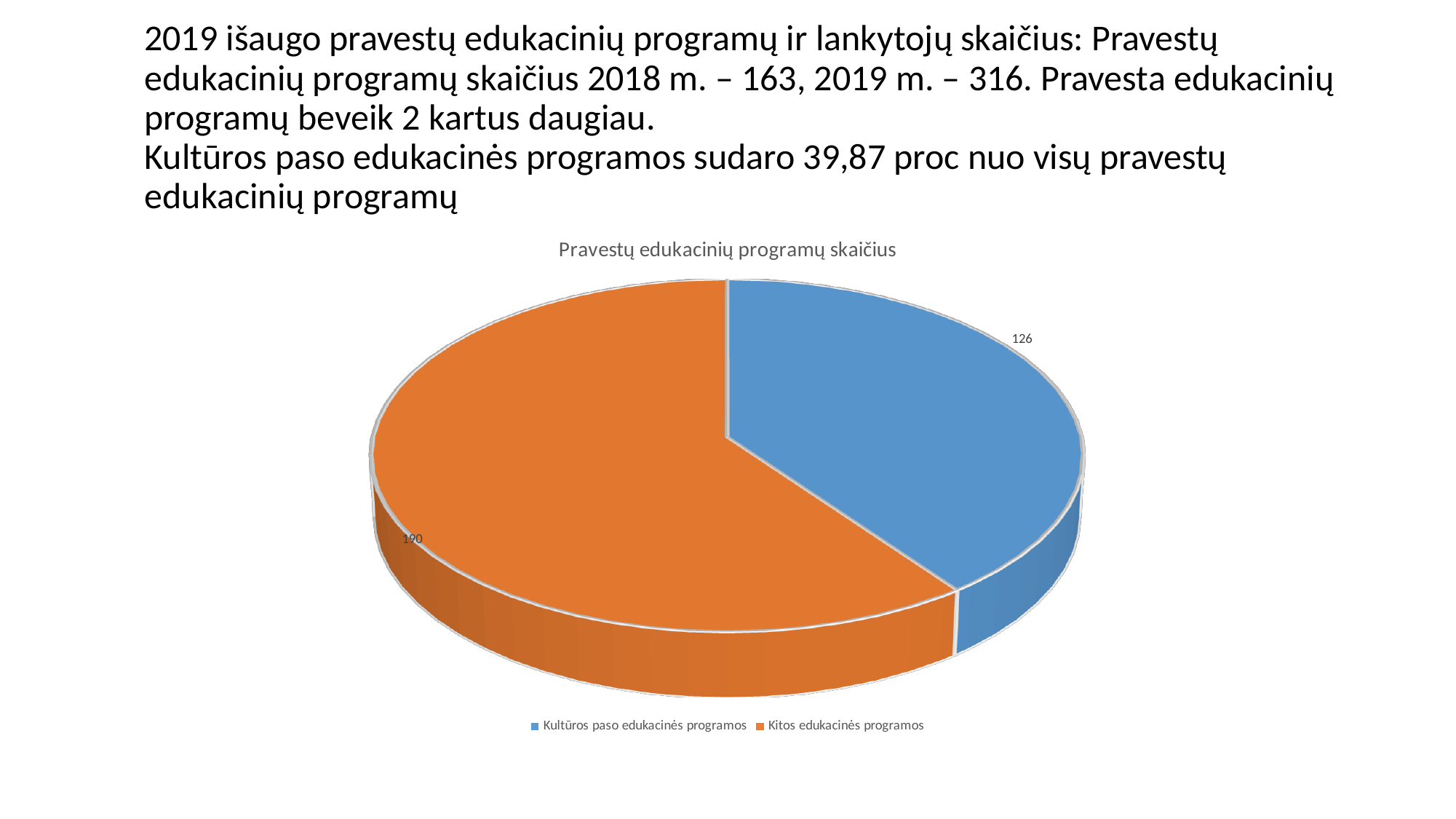
How many entries does the legend list? 2 What is the value for Kitos edukacinės programos? 190 How many slices does the pie chart have? 2 Which is larger: Kultūros paso edukacinės programos or Kitos edukacinės programos? Kitos edukacinės programos Which category has the largest slice of the pie? Kitos edukacinės programos What is the total of all slices in the pie chart? 316 What is the title of the chart? Pravestų edukacinių programų skaičius What is the value for Kultūros paso edukacinės programos? 126 What is the difference between the values for Kitos edukacinės programos and Kultūros paso edukacinės programos? 64 Which category has the smallest slice of the pie? Kultūros paso edukacinės programos Which colour represents Kitos edukacinės programos in the pie chart? orange What type of chart is shown on the slide? pie chart